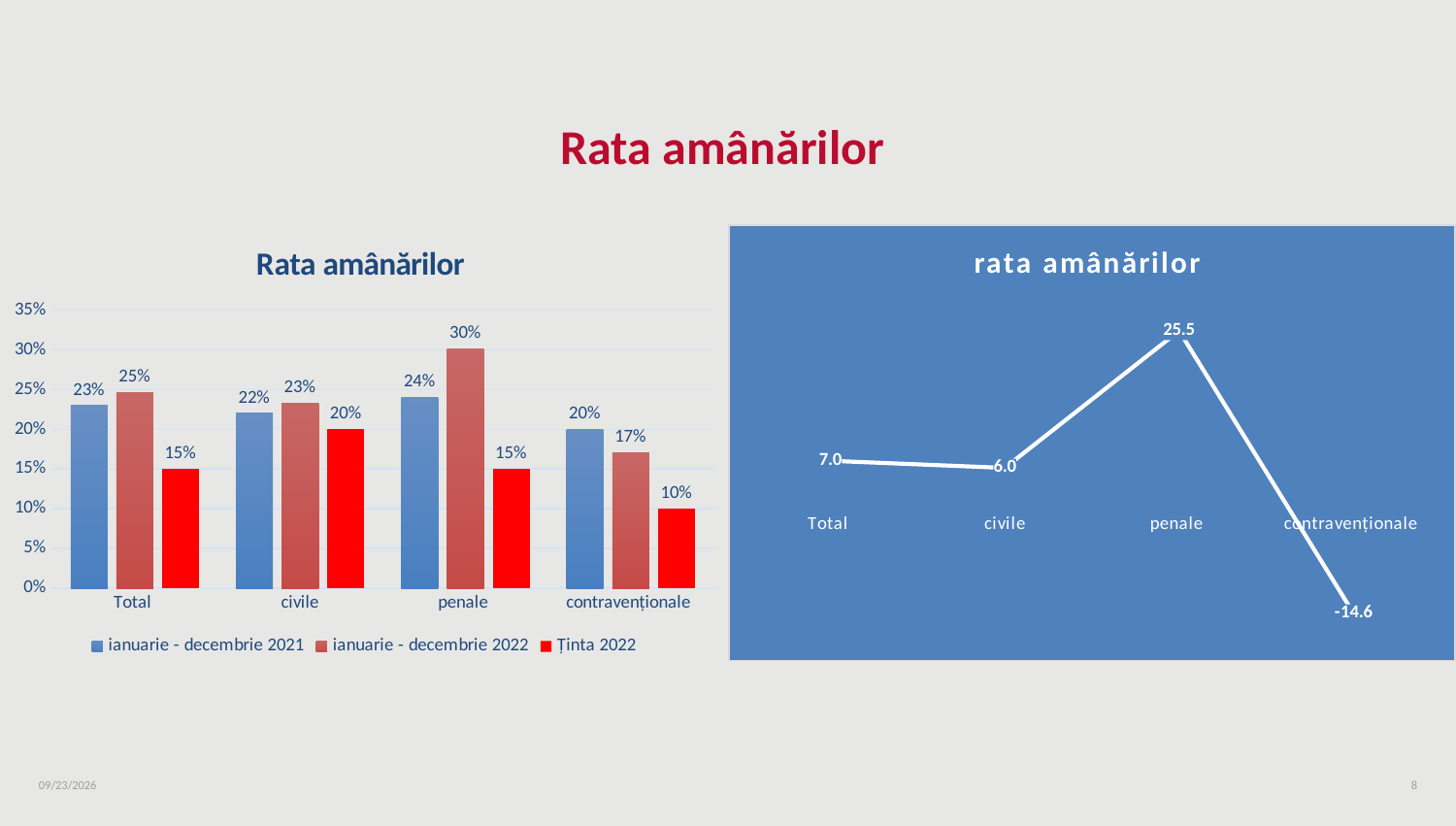
How many categories are shown on the x axis of the line chart on the right? 4 In the bar chart on the left, which category has the highest ianuarie - decembrie 2022 value? penale In the bar chart on the left, what is the value for Total in the ianuarie - decembrie 2021 series? 23% In the bar chart on the left, what is the value for penale in the ianuarie - decembrie 2022 series? 30% In the bar chart on the left, what is the Ținta 2022 value for contravenționale? 10% In the bar chart on the left, which is larger for civile: the ianuarie - decembrie 2021 value or the ianuarie - decembrie 2022 value? ianuarie - decembrie 2022 In the bar chart on the left, what is the difference between the ianuarie - decembrie 2022 value and the Ținta 2022 value for penale? 15% What kind of chart is the chart on the right of the slide? line chart In the bar chart on the left, which category has the lowest Ținta 2022 value? contravenționale In the line chart on the right, what is the value for penale? 25.5 How many series does the legend of the bar chart on the left list? 3 In the line chart on the right, what is the value for contravenționale? -14.6